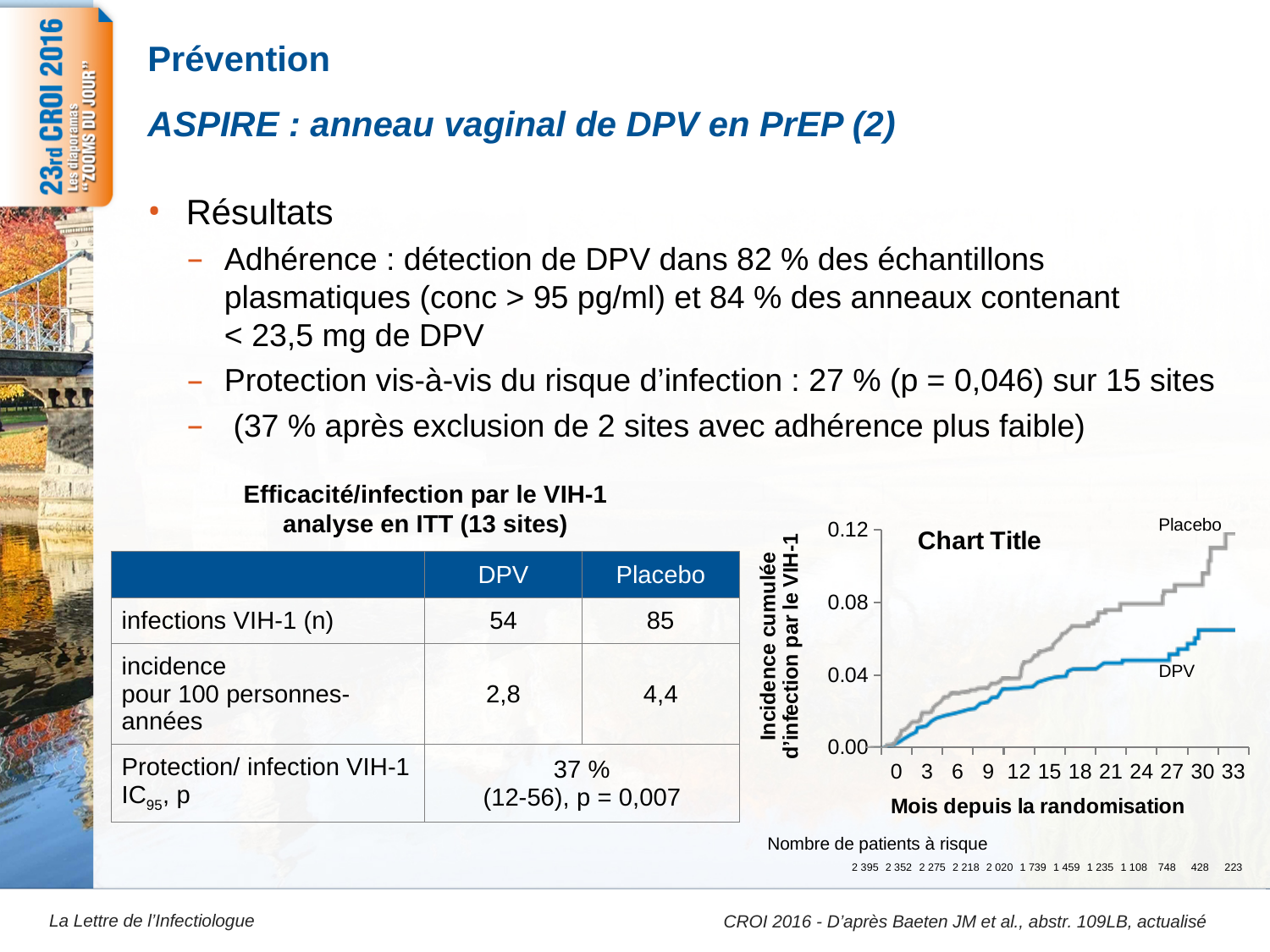
How many tick labels are shown on the x axis of the line chart? 12 Which series has the lowest cumulative incidence at 33 months in the line chart? DPV Do the cumulative incidence curves rise or fall as months since randomisation increase? rise Which series reaches the highest cumulative incidence in the line chart? Placebo What kind of chart is shown on the right of the slide? line chart What is the x-axis title of the line chart? Mois depuis la randomisation Is the cumulative incidence for DPV at 33 months greater or less than 0.08? less How many series are plotted in the line chart? 2 What colour is the DPV line in the chart? blue Is the cumulative incidence for Placebo at 33 months greater or less than 0.08? greater Is the cumulative incidence for DPV at 33 months greater or less than 0.04? greater At 30 months, which series has the higher cumulative incidence, Placebo or DPV? Placebo